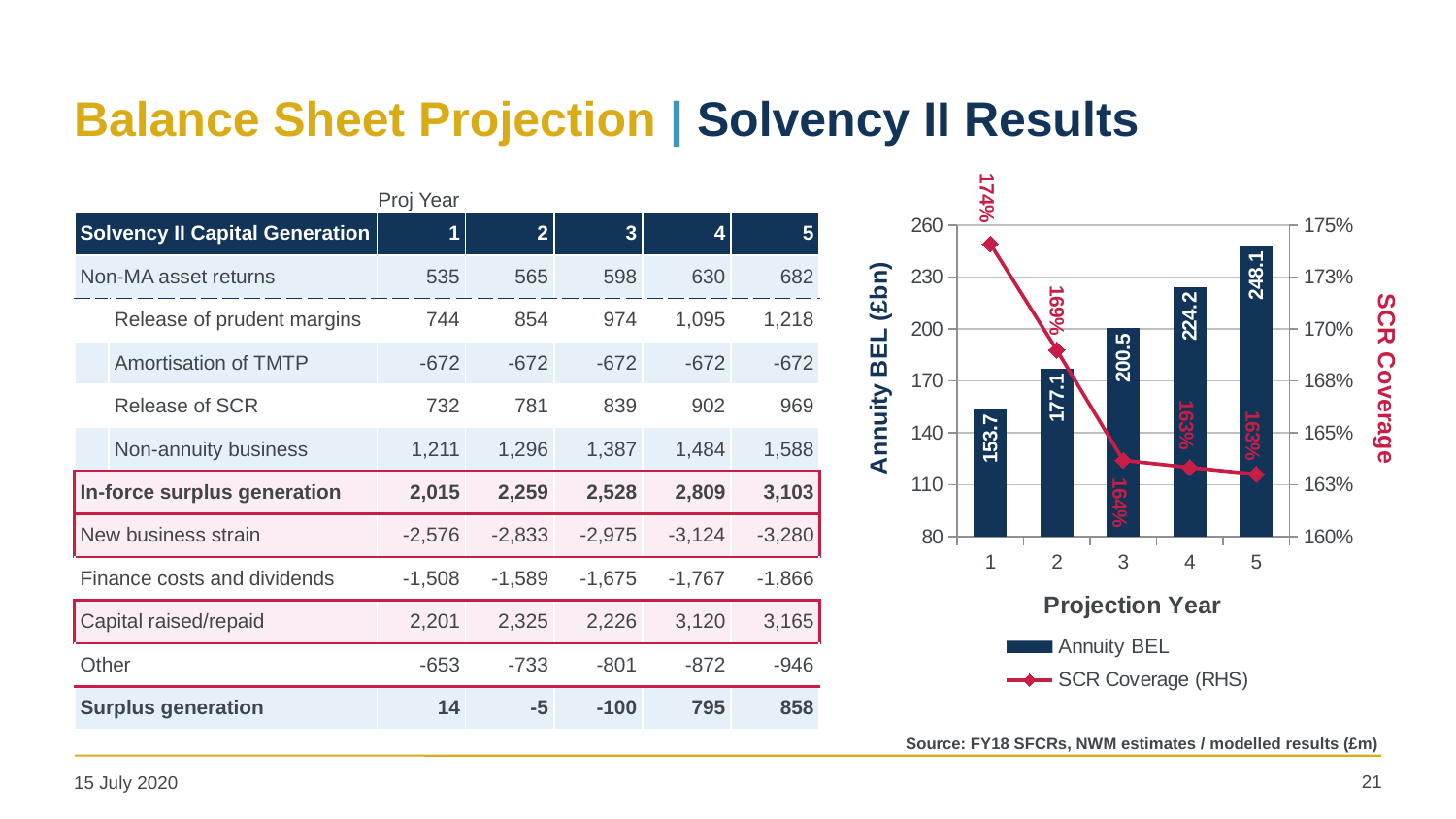
What is the SCR Coverage for projection year 1? 174% Which series is plotted on the right-hand axis of the chart? SCR Coverage (RHS) Which projection year has the highest Annuity BEL? 5 Which projection year has the highest SCR Coverage? 1 What is the Annuity BEL value for projection year 3? 200.5 Which projection year has the lowest Annuity BEL? 1 What is the difference in Annuity BEL between projection year 5 and projection year 1? 94.4 What is the Annuity BEL value for projection year 5? 248.1 Does the Annuity BEL rise or fall from projection year 1 to projection year 5? Rise How many series does the chart legend list? 2 Is the SCR Coverage higher in projection year 2 or projection year 3? Projection year 2 How many projection years are shown on the chart's x axis? 5